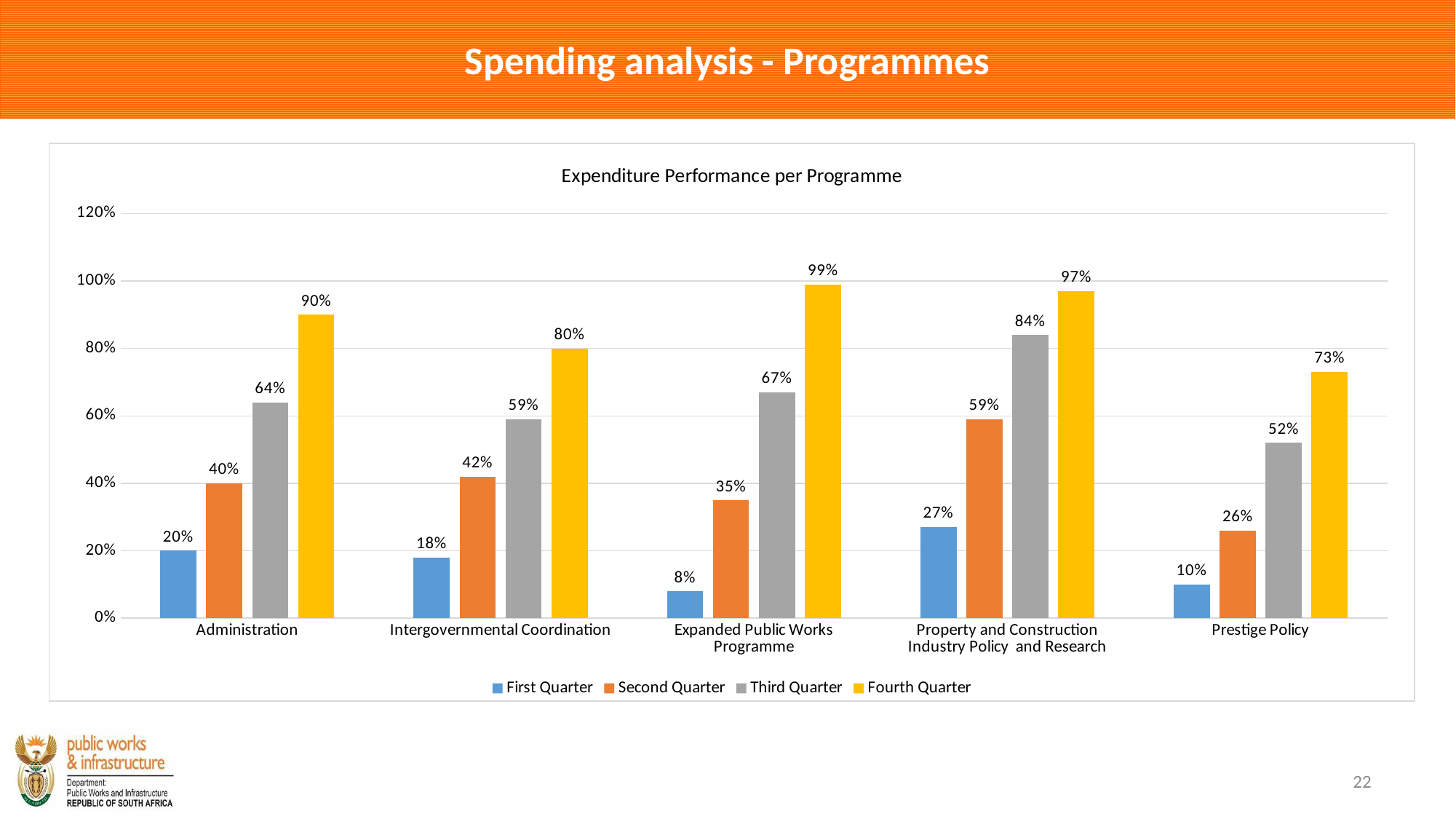
What is the title of the chart? Expenditure Performance per Programme What is the Fourth Quarter value for Administration? 90% Which is larger: the Second Quarter value for Intergovernmental Coordination or the Second Quarter value for Prestige Policy? Intergovernmental Coordination How many programmes are shown on the x axis? 5 What is the Third Quarter value for Property and Construction Industry Policy and Research? 84% What is the First Quarter value for Expanded Public Works Programme? 8% What kind of chart is shown? Bar chart Which programme has the highest Fourth Quarter value? Expanded Public Works Programme What is the difference between the Fourth Quarter and Third Quarter values for Prestige Policy? 21% How many series does the legend list? 4 Is the Third Quarter value for Expanded Public Works Programme greater or less than 60%? greater Which programme has the lowest First Quarter value? Expanded Public Works Programme